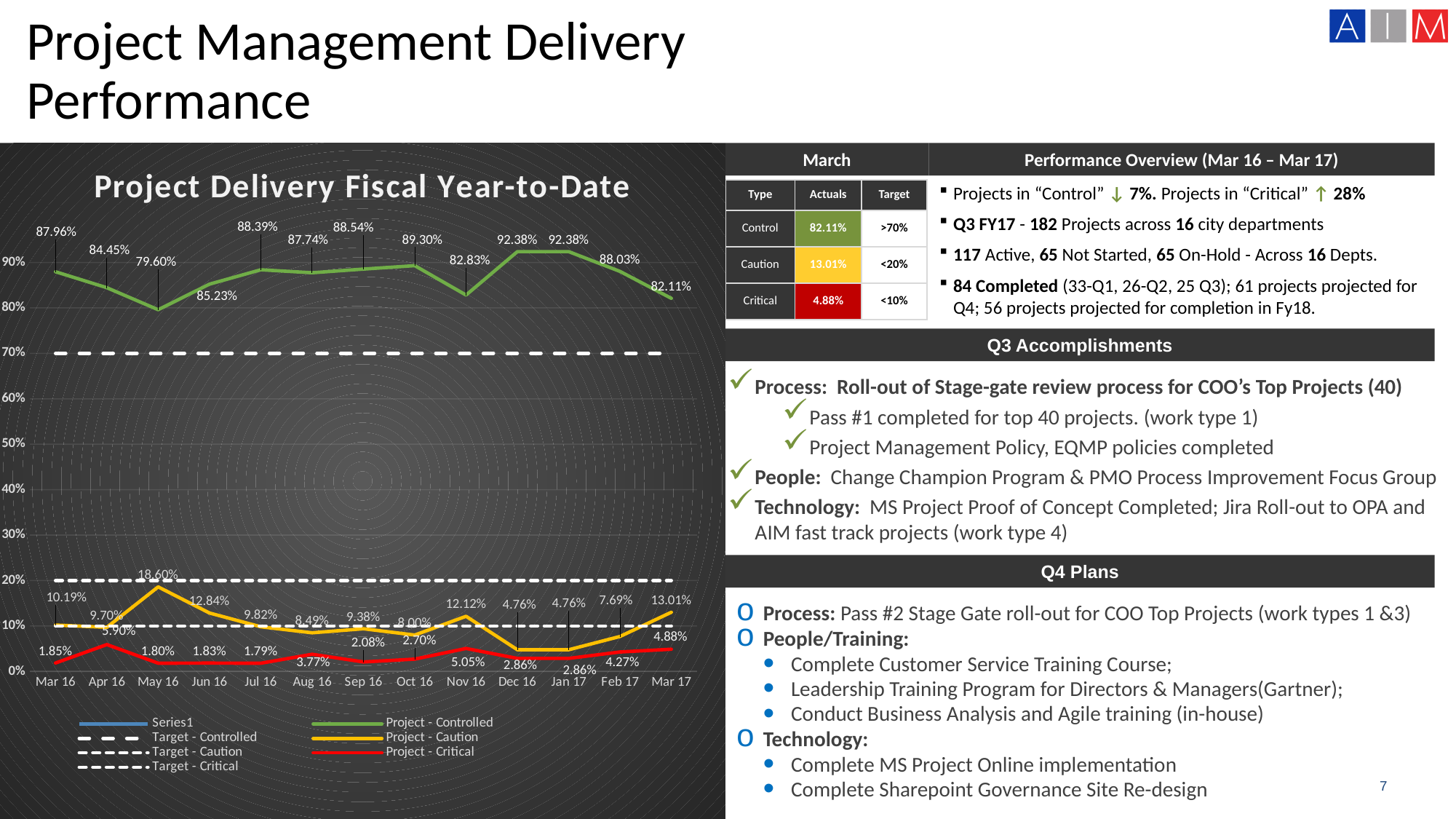
What type of chart is the Project Delivery Fiscal Year-to-Date chart? Line chart In the Project Delivery Fiscal Year-to-Date chart, which month has the highest Project - Caution value? May 16 In the Project Delivery Fiscal Year-to-Date chart, what is the value of Project - Controlled for Mar 17? 82.11% In the Project Delivery Fiscal Year-to-Date chart, which month has the lowest Project - Controlled value? May 16 In the Project Delivery Fiscal Year-to-Date chart, is the Project - Controlled value for Dec 16 greater or less than 90%? greater In the Project Delivery Fiscal Year-to-Date chart, by how many percentage points did Project - Controlled fall from Mar 16 to Mar 17? 5.85 percentage points How many months are plotted along the x axis of the Project Delivery Fiscal Year-to-Date chart? 13 How many entries does the legend of the Project Delivery Fiscal Year-to-Date chart list? 7 In the Project Delivery Fiscal Year-to-Date chart, what is the value of Project - Critical for Feb 17? 4.27% What is the title of the chart on the left side of the slide? Project Delivery Fiscal Year-to-Date In the Project Delivery Fiscal Year-to-Date chart, is the Project - Critical value higher in Apr 16 or Nov 16? Apr 16 In the Project Delivery Fiscal Year-to-Date chart, what is the value of Project - Caution for May 16? 18.60%